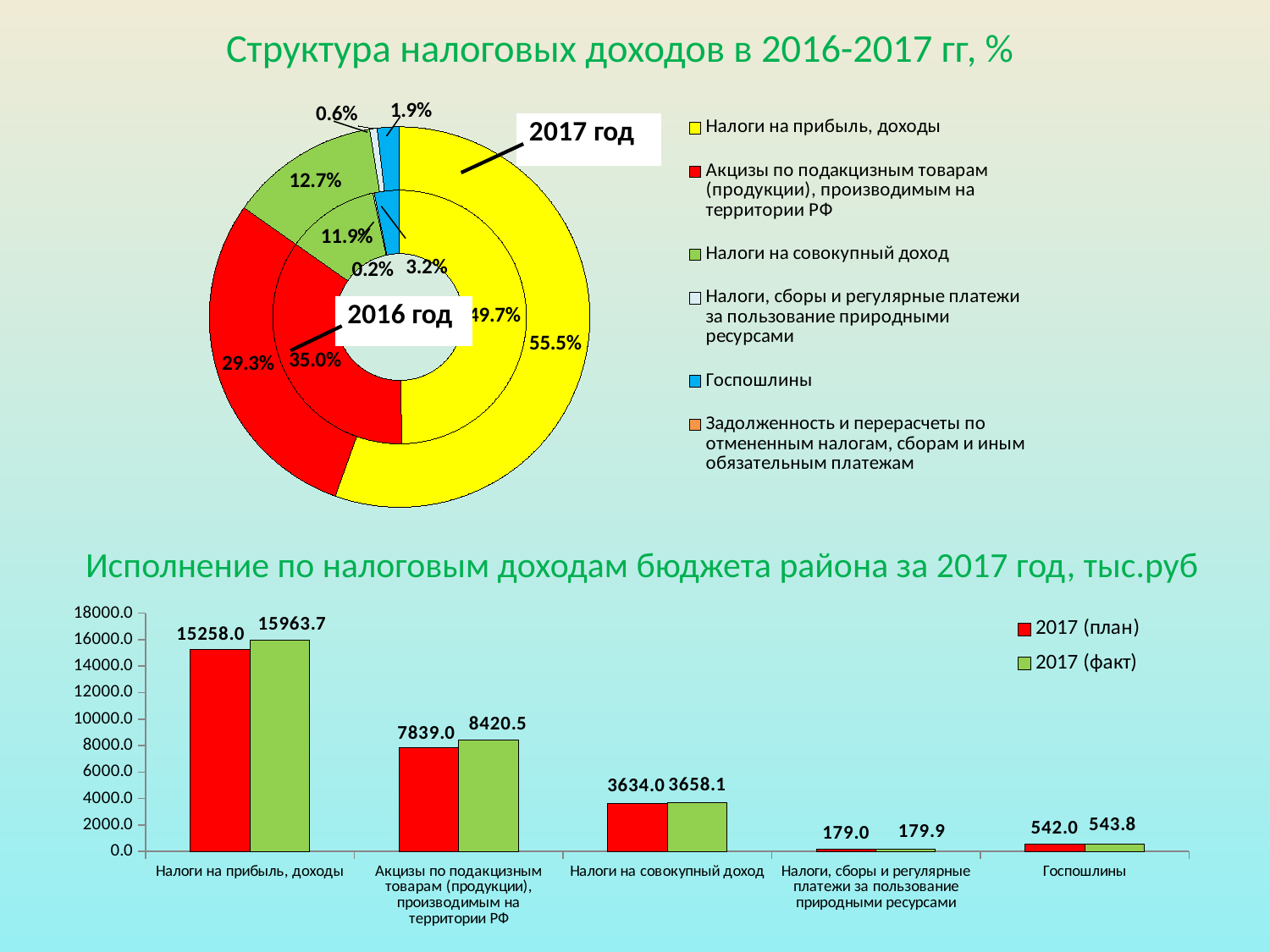
In the top chart 'Структура налоговых доходов в 2016-2017 гг, %', what is the share of 'Госпошлины' in 2016? 3.2% In the top chart 'Структура налоговых доходов в 2016-2017 гг, %', what is the share of 'Налоги на прибыль, доходы' in 2017? 55.5% What kind of chart is the bottom chart 'Исполнение по налоговым доходам бюджета района за 2017 год, тыс.руб'? bar chart In the bottom chart 'Исполнение по налоговым доходам бюджета района за 2017 год, тыс.руб', how many categories are shown on the x axis? 5 In the bottom chart 'Исполнение по налоговым доходам бюджета района за 2017 год, тыс.руб', what is the difference between the 2017 (факт) and 2017 (план) values for 'Налоги на прибыль, доходы'? 705.7 In the bottom chart 'Исполнение по налоговым доходам бюджета района за 2017 год, тыс.руб', what is the 2017 (факт) value for 'Акцизы по подакцизным товарам (продукции), производимым на территории РФ'? 8420.5 In the top chart 'Структура налоговых доходов в 2016-2017 гг, %', which is larger: the 2016 share of 'Акцизы по подакцизным товарам (продукции), производимым на территории РФ' or the 2017 share? 2016 (35.0%) In the top chart 'Структура налоговых доходов в 2016-2017 гг, %', how many entries does the legend list? 6 In the bottom chart 'Исполнение по налоговым доходам бюджета района за 2017 год, тыс.руб', how many series does the legend list? 2 In the bottom chart 'Исполнение по налоговым доходам бюджета района за 2017 год, тыс.руб', what is the 2017 (план) value for 'Налоги на прибыль, доходы'? 15258.0 In the bottom chart 'Исполнение по налоговым доходам бюджета района за 2017 год, тыс.руб', which category has the highest 2017 (план) value? Налоги на прибыль, доходы In the bottom chart 'Исполнение по налоговым доходам бюджета района за 2017 год, тыс.руб', which category has the lowest 2017 (факт) value? Налоги, сборы и регулярные платежи за пользование природными ресурсами